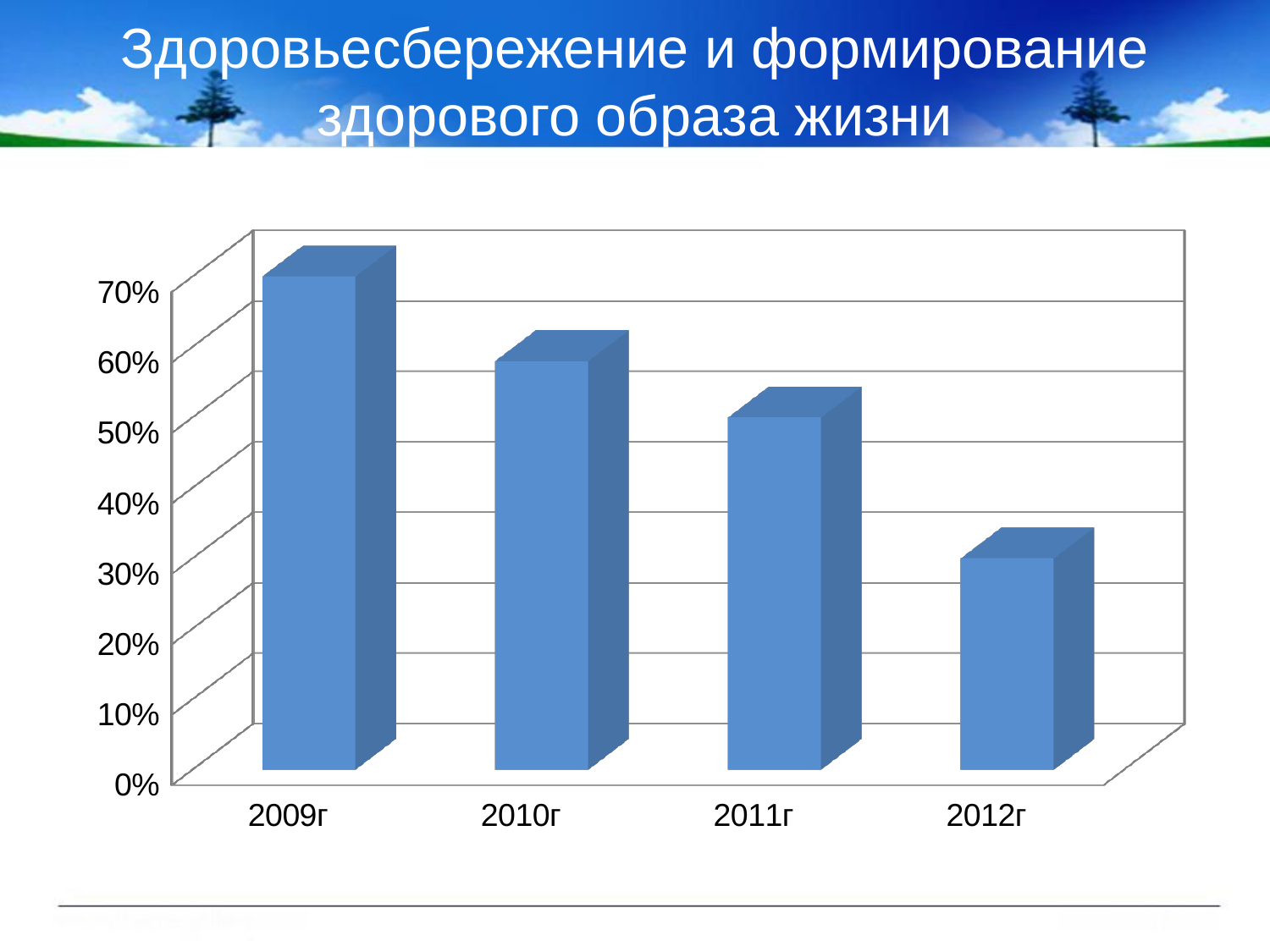
Which year has the lowest value on the chart? 2012г Which is larger, the value for 2010г or the value for 2011г? 2010г Which is larger, the value for 2009г or the value for 2012г? 2009г How many categories (years) are plotted on the chart? 4 What kind of chart is shown on the slide? bar chart Is the value for 2012г greater or less than 40%? less Which year has the highest value on the chart? 2009г Is the value for 2010г greater or less than 50%? greater Is the value for 2011г greater or less than 40%? greater What colour are the bars on the chart? blue Do the values rise or fall from 2009г to 2012г? fall